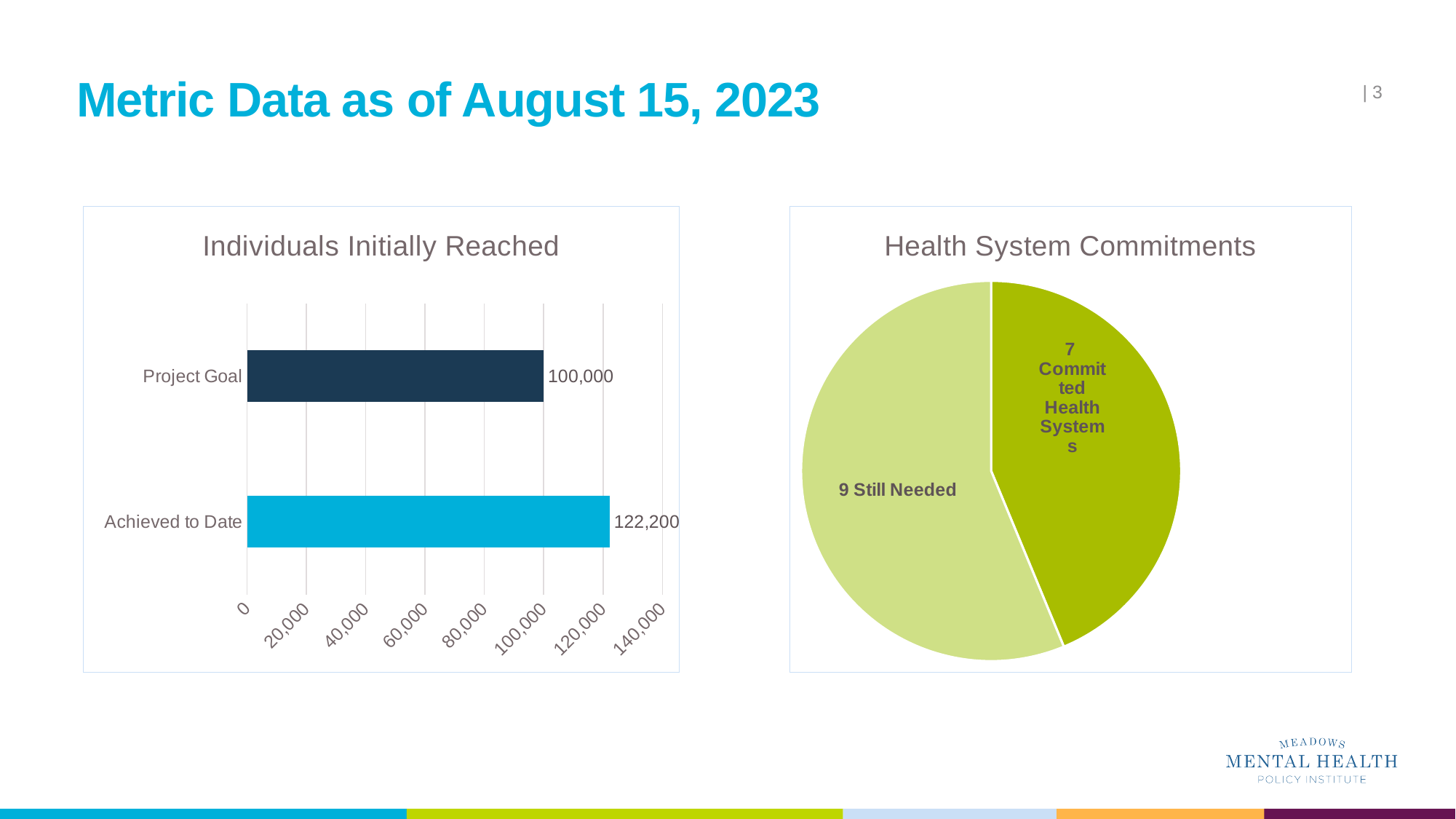
In the 'Individuals Initially Reached' chart, what is the difference between Achieved to Date and Project Goal? 22,200 In the 'Individuals Initially Reached' chart, what is the value for Project Goal? 100,000 What kind of chart is 'Health System Commitments'? Pie chart In the 'Individuals Initially Reached' chart, which category has the lower value? Project Goal In the 'Individuals Initially Reached' chart, is the value for Achieved to Date greater or less than 120,000? greater In the 'Health System Commitments' chart, how many health systems are still needed? 9 In the 'Health System Commitments' chart, which slice is larger: Still Needed or Committed Health Systems? Still Needed What kind of chart is 'Individuals Initially Reached'? Bar chart In the 'Health System Commitments' chart, how many health systems are committed? 7 In the 'Individuals Initially Reached' chart, what is the value for Achieved to Date? 122,200 In the 'Individuals Initially Reached' chart, which category has the higher value? Achieved to Date In the 'Individuals Initially Reached' chart, how many categories are shown? 2